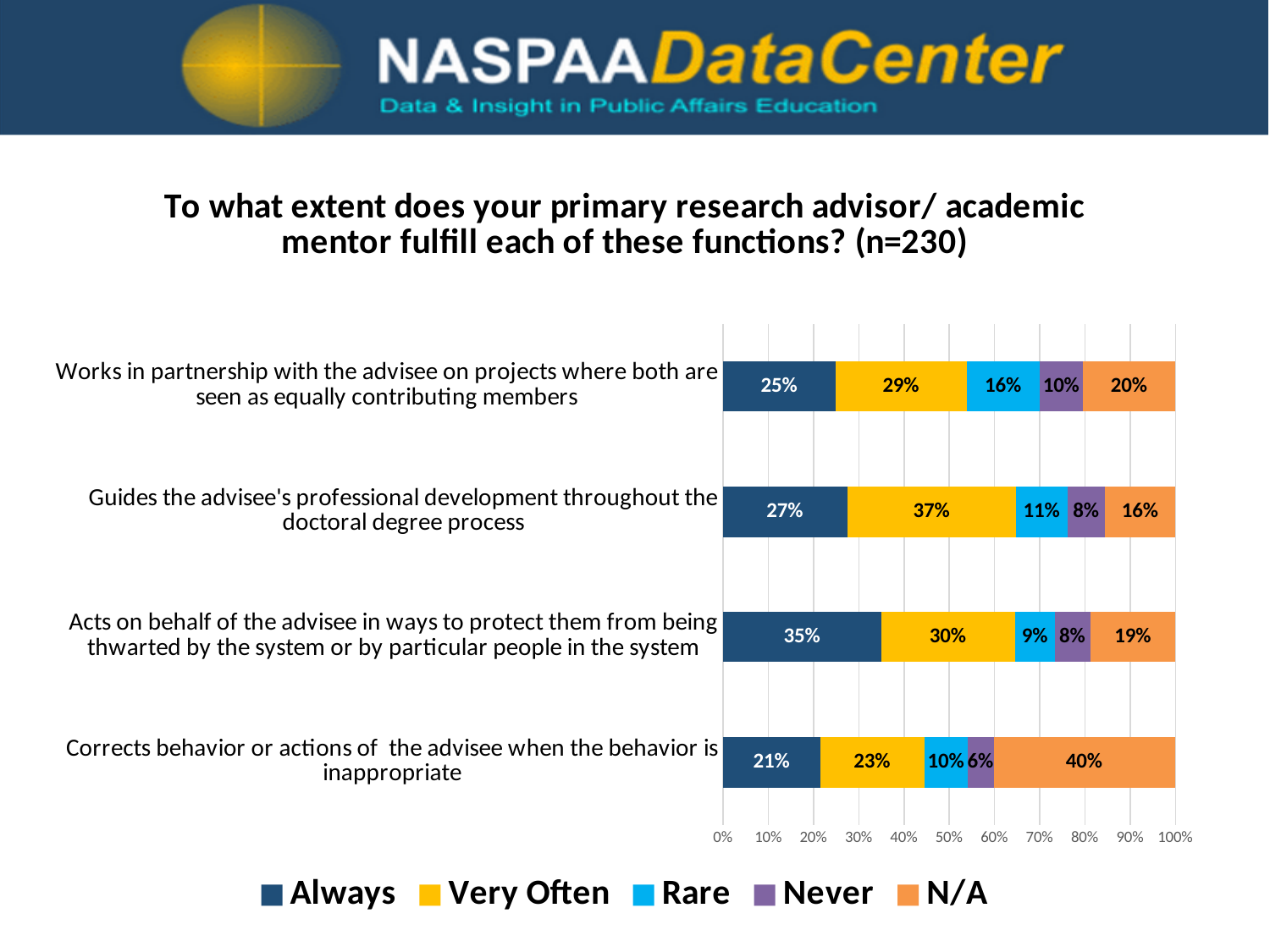
Which is larger: the "Very Often" value for "Works in partnership with the advisee" or the "Very Often" value for "Acts on behalf of the advisee"? Acts on behalf of the advisee What is the total of the stacked bar for "Works in partnership with the advisee on projects where both are seen as equally contributing members"? 100% Which function has the highest "Always" percentage? Acts on behalf of the advisee in ways to protect them from being thwarted by the system or by particular people in the system Which function has the lowest "Always" percentage? Corrects behavior or actions of the advisee when the behavior is inappropriate How many functions (categories) are shown in the chart? 4 What percentage of respondents said their advisor "Always" acts on behalf of the advisee in ways to protect them from being thwarted by the system? 35% What is the "Rare" value for "Works in partnership with the advisee on projects where both are seen as equally contributing members"? 16% What is the "Very Often" value for "Guides the advisee's professional development throughout the doctoral degree process"? 37% What is the difference between the N/A value for "Corrects behavior or actions of the advisee" and the N/A value for "Guides the advisee's professional development"? 24% What is the N/A share for "Corrects behavior or actions of the advisee when the behavior is inappropriate"? 40% How many series does the legend list? 5 What type of chart is shown on the slide? Stacked bar chart